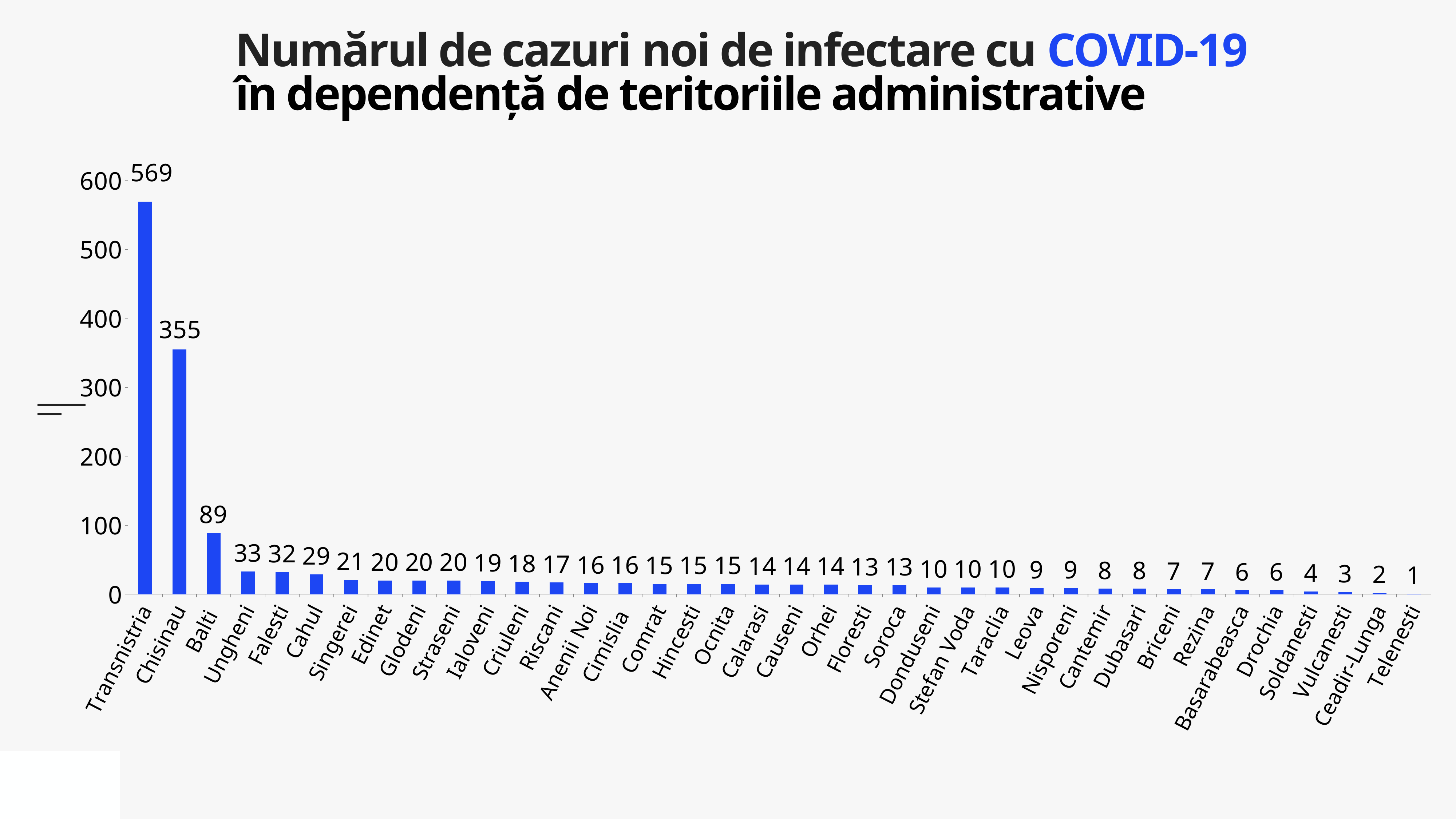
What is the difference between the values for Transnistria and Chisinau? 214 What is the value for Chisinau? 355 Which is larger, the value for Ungheni or the value for Soroca? Ungheni Is the value for Chisinau greater or less than 300? greater Which territory has the lowest number of new cases? Telenesti Which territory has the highest number of new cases? Transnistria Do the values rise or fall from left to right along the x axis? fall What is the value for Cahul? 29 What is the value for Balti? 89 What is the value for Transnistria? 569 What kind of chart is shown on the slide? bar chart How many territories are shown on the x axis? 38